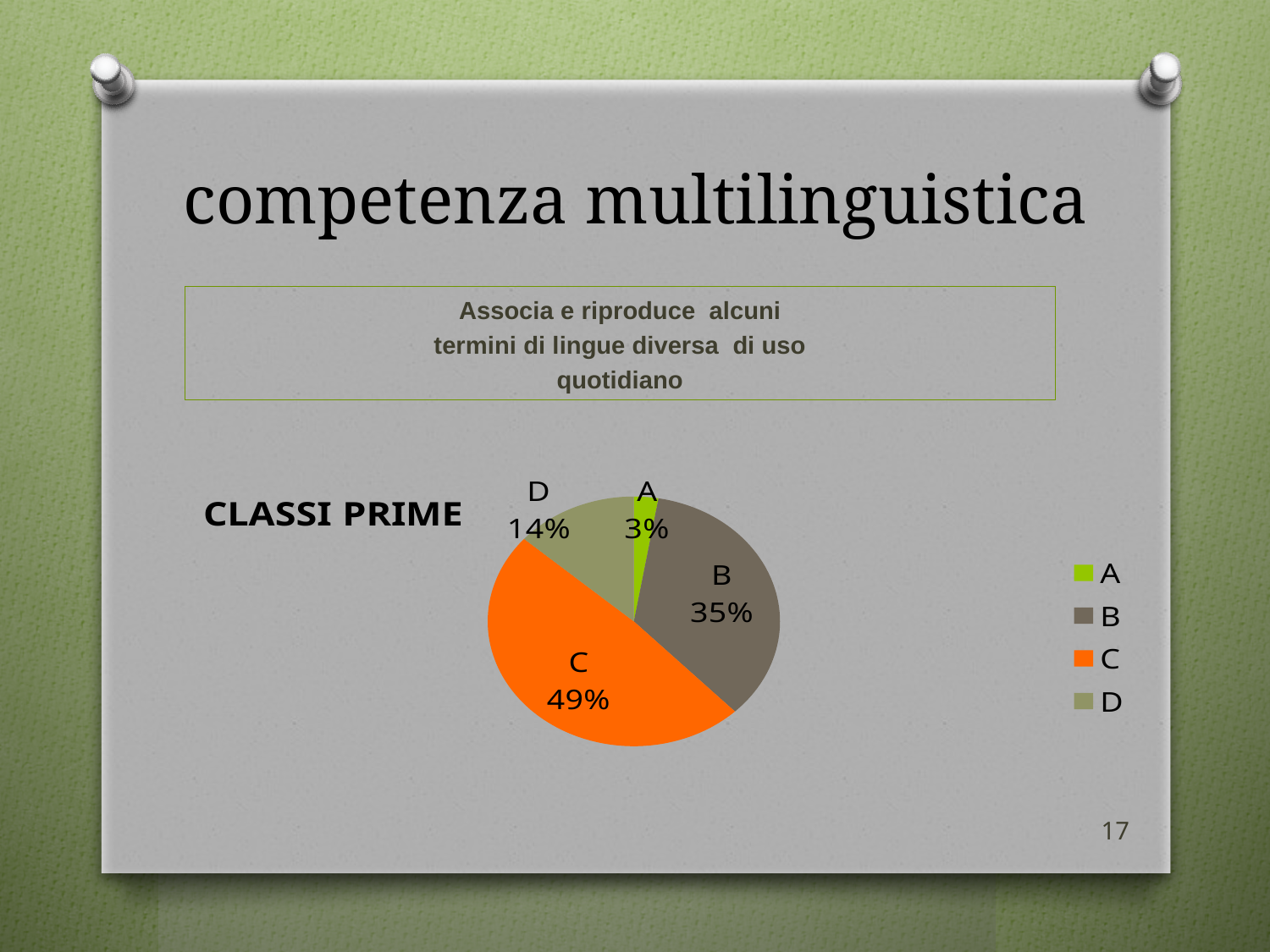
What colour is slice C in the pie chart? orange What type of chart is shown on the slide? pie chart What percentage does slice C represent in the pie chart? 49% Which slice is the smallest in the pie chart? A How many slices does the pie chart have? 4 Which slice is the largest in the pie chart? C What percentage does slice A represent in the pie chart? 3% Which is larger, slice B or slice D? B How many entries does the legend list? 4 What percentage does slice B represent in the pie chart? 35% What percentage does slice D represent in the pie chart? 14% What is the difference in percentage points between slice C and slice B? 14